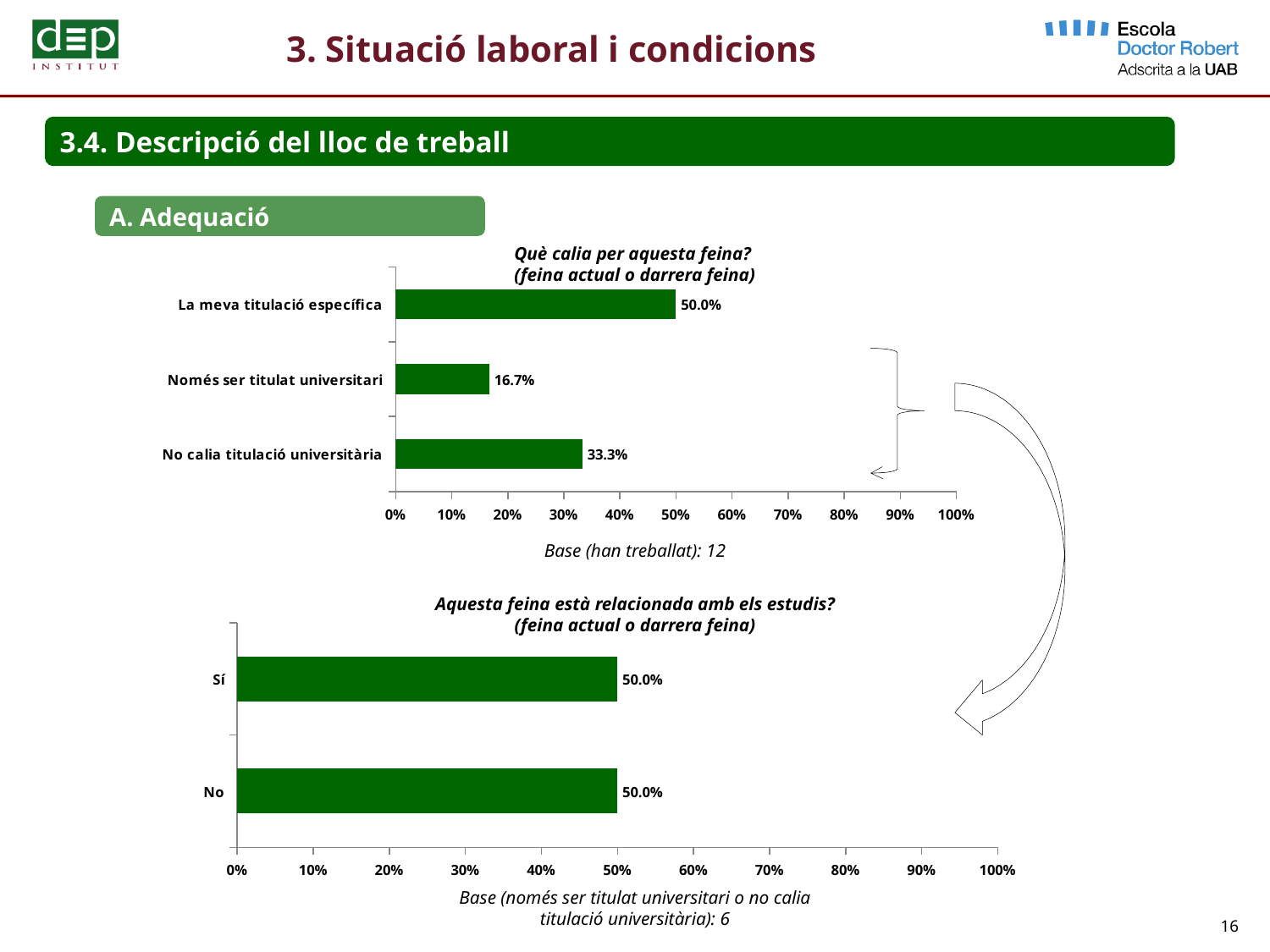
In the chart 'Aquesta feina està relacionada amb els estudis?', what is the value for 'Sí'? 50.0% What kind of chart is the chart 'Aquesta feina està relacionada amb els estudis?'? Bar chart In the chart 'Què calia per aquesta feina?', what is the value for 'No calia titulació universitària'? 33.3% How many categories are shown in the chart 'Aquesta feina està relacionada amb els estudis?'? 2 In the chart 'Què calia per aquesta feina?', which category has the highest value? La meva titulació específica In the chart 'Què calia per aquesta feina?', what is the difference between 'No calia titulació universitària' and 'Només ser titulat universitari'? 16.6% In the chart 'Aquesta feina està relacionada amb els estudis?', what is the value for 'No'? 50.0% In the chart 'Què calia per aquesta feina?', which is larger: 'La meva titulació específica' or 'No calia titulació universitària'? La meva titulació específica How many categories are shown in the chart 'Què calia per aquesta feina?'? 3 In the chart 'Què calia per aquesta feina?', which category has the lowest value? Només ser titulat universitari In the chart 'Què calia per aquesta feina?', what is the value for 'Només ser titulat universitari'? 16.7% In the chart 'Què calia per aquesta feina?', what is the value for 'La meva titulació específica'? 50.0%